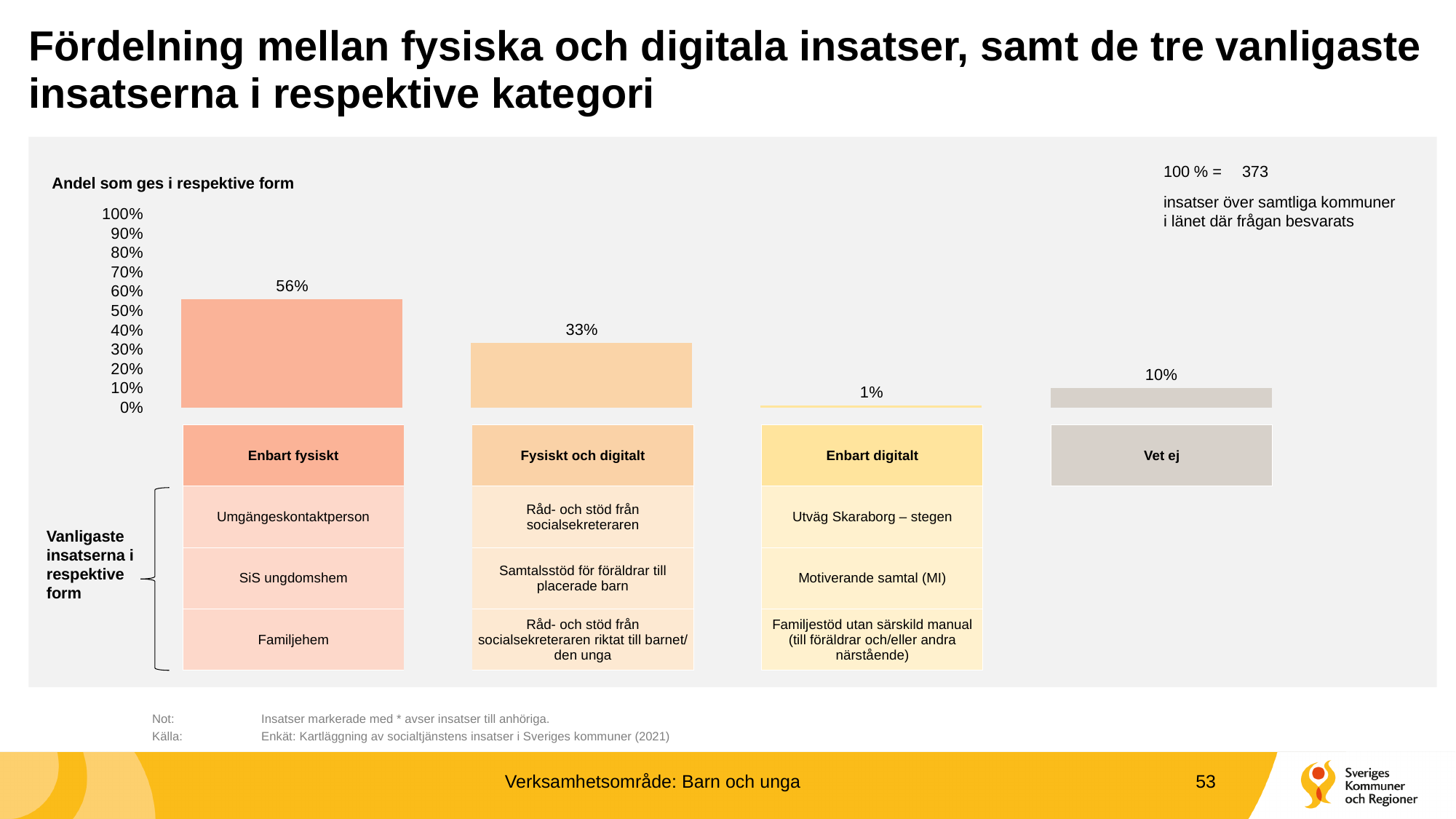
What is the value for Enbart fysiskt? 56% What is the value for Fysiskt och digitalt? 33% How many categories are shown in the chart? 4 Which category has the highest value? Enbart fysiskt Which category has the lowest value? Enbart digitalt Which is larger, Vet ej or Enbart digitalt? Vet ej What is the difference between Enbart fysiskt and Fysiskt och digitalt? 23% What kind of chart is shown? Bar chart What is the value for Vet ej? 10% What number of insatser does 100 % correspond to according to the note on the slide? 373 What is the value for Enbart digitalt? 1% What is the title of the chart? Andel som ges i respektive form